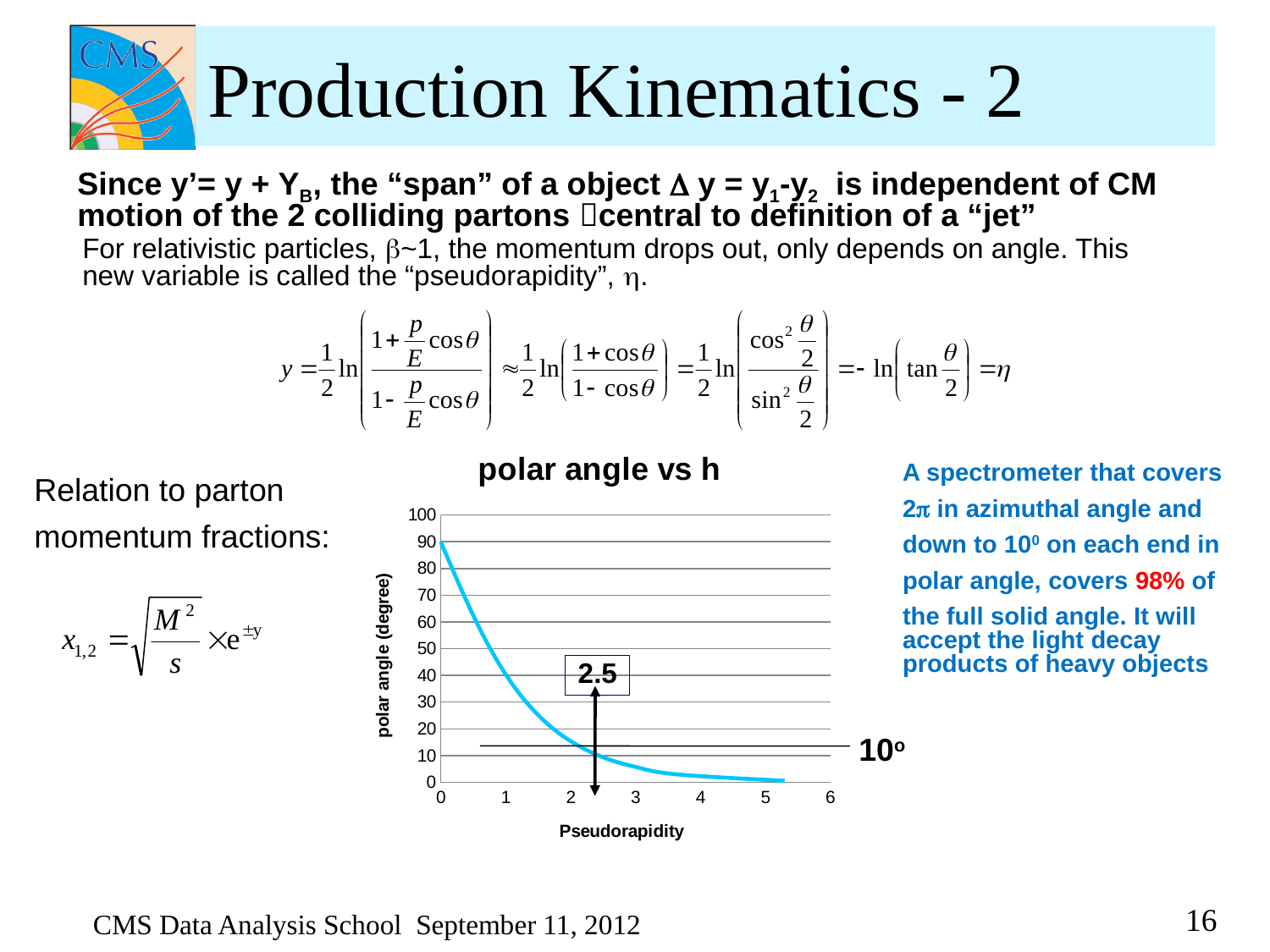
Is the polar angle at pseudorapidity 1 greater or less than 50? less Is the polar angle at pseudorapidity 3 greater or less than 10? less What kind of chart is shown on the slide? line chart What is the highest value shown on the x axis of the chart? 6 What is the title of the chart? polar angle vs h Does the polar angle rise or fall as pseudorapidity increases along the x axis? fall Is the polar angle at pseudorapidity 2 greater or less than 20? less Which has the larger polar angle: pseudorapidity 1 or pseudorapidity 4? pseudorapidity 1 What is the highest value shown on the y axis of the chart? 100 What is the label of the x axis of the chart? Pseudorapidity What is the polar angle (degree) at pseudorapidity 0? 90